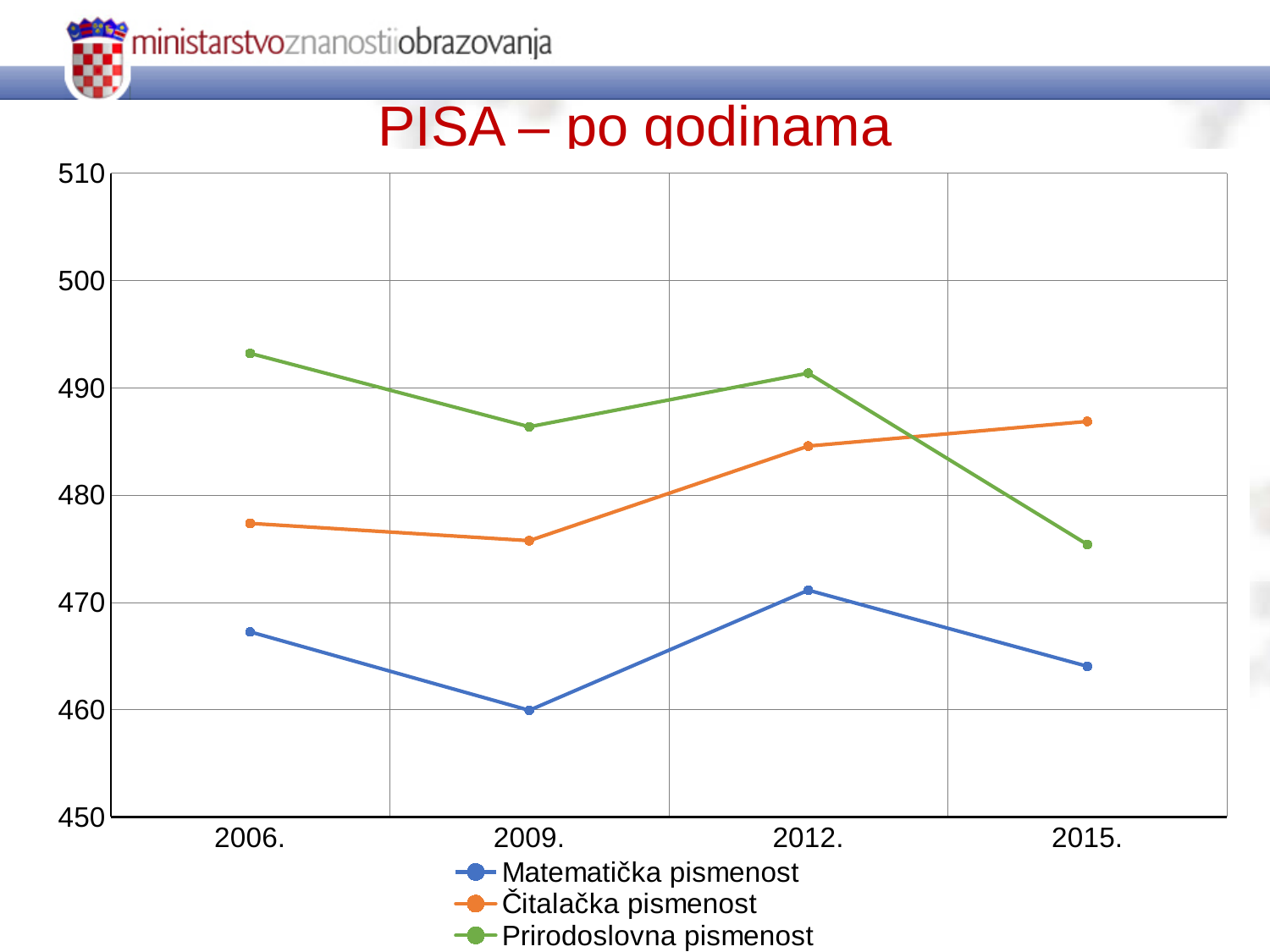
How many years are shown on the x axis? 4 In 2015., which is larger: Čitalačka pismenost or Prirodoslovna pismenost? Čitalačka pismenost What is the title of the chart? PISA – po godinama In which year does Matematička pismenost reach its lowest value? 2009. Does Prirodoslovna pismenost rise or fall from 2012. to 2015.? fall Is the value for Prirodoslovna pismenost in 2015. greater or less than 480? less What kind of chart is shown on the slide? line chart Which series is drawn in green? Prirodoslovna pismenost How many series does the legend list? 3 In which year does Prirodoslovna pismenost reach its highest value? 2006. Is the value for Čitalačka pismenost in 2009. greater or less than 480? less Is the value for Prirodoslovna pismenost in 2006. greater or less than 490? greater